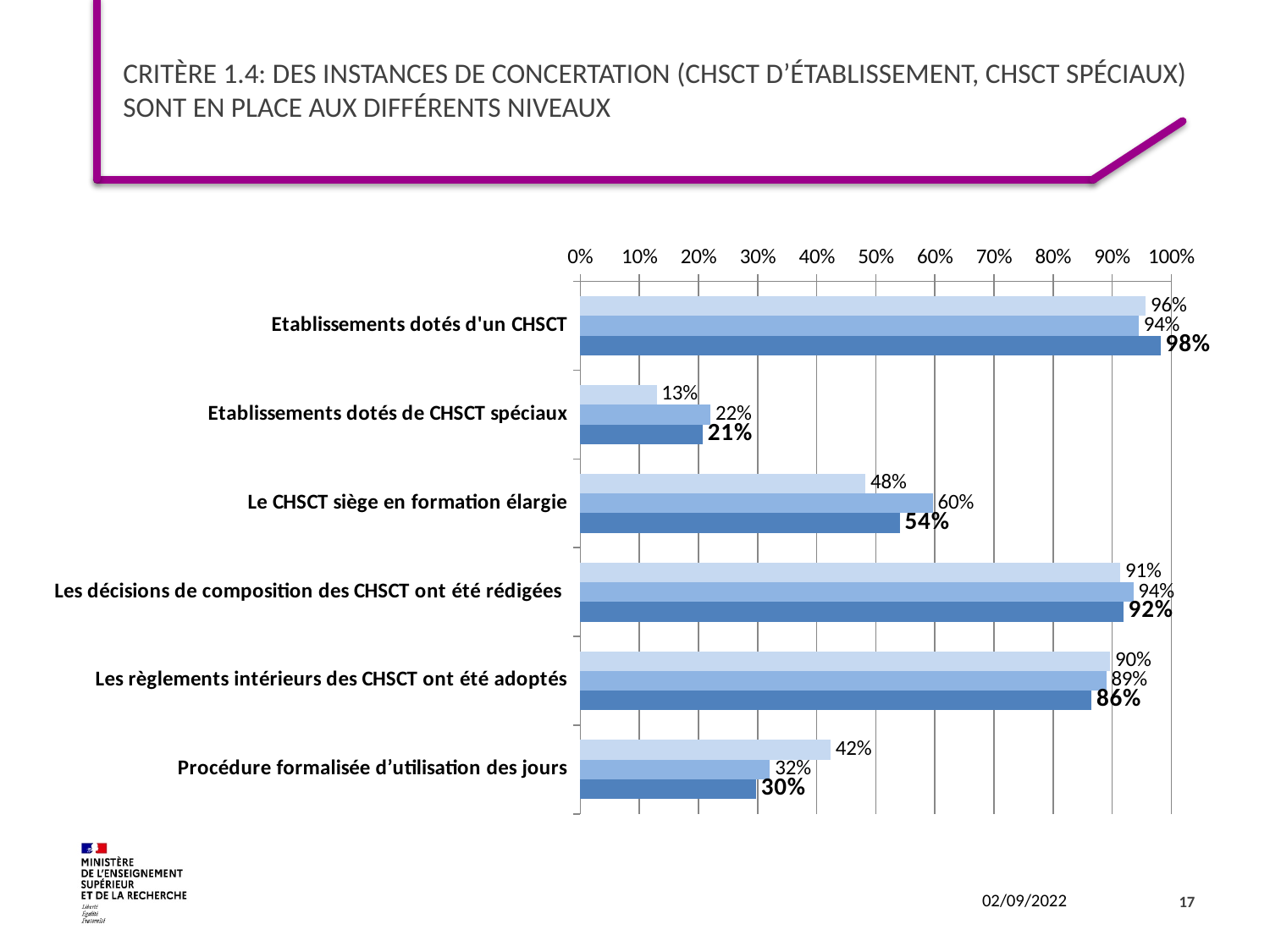
Which category has the lowest value for the dark blue (bottom) bar? Etablissements dotés de CHSCT spéciaux What is the value of the light blue (top) bar for 'Etablissements dotés de CHSCT spéciaux'? 13% What is the value of the dark blue (bottom) bar for 'Procédure formalisée d'utilisation des jours'? 30% How many categories are shown on the chart? 6 What is the difference between the medium blue (middle) bar and the light blue (top) bar for 'Le CHSCT siège en formation élargie'? 12% What type of chart is shown on the slide? bar chart What is the difference between the dark blue (bottom) bar for 'Les règlements intérieurs des CHSCT ont été adoptés' and the dark blue (bottom) bar for 'Les décisions de composition des CHSCT ont été rédigées'? 6% Which category has the highest value for the light blue (top) bar? Etablissements dotés d'un CHSCT What is the value of the dark blue (bottom) bar for 'Etablissements dotés d'un CHSCT'? 98% How many bars are shown for each category on the chart? 3 What is the value of the medium blue (middle) bar for 'Le CHSCT siège en formation élargie'? 60% For 'Procédure formalisée d'utilisation des jours', which is larger: the light blue (top) bar or the medium blue (middle) bar? light blue (top) bar